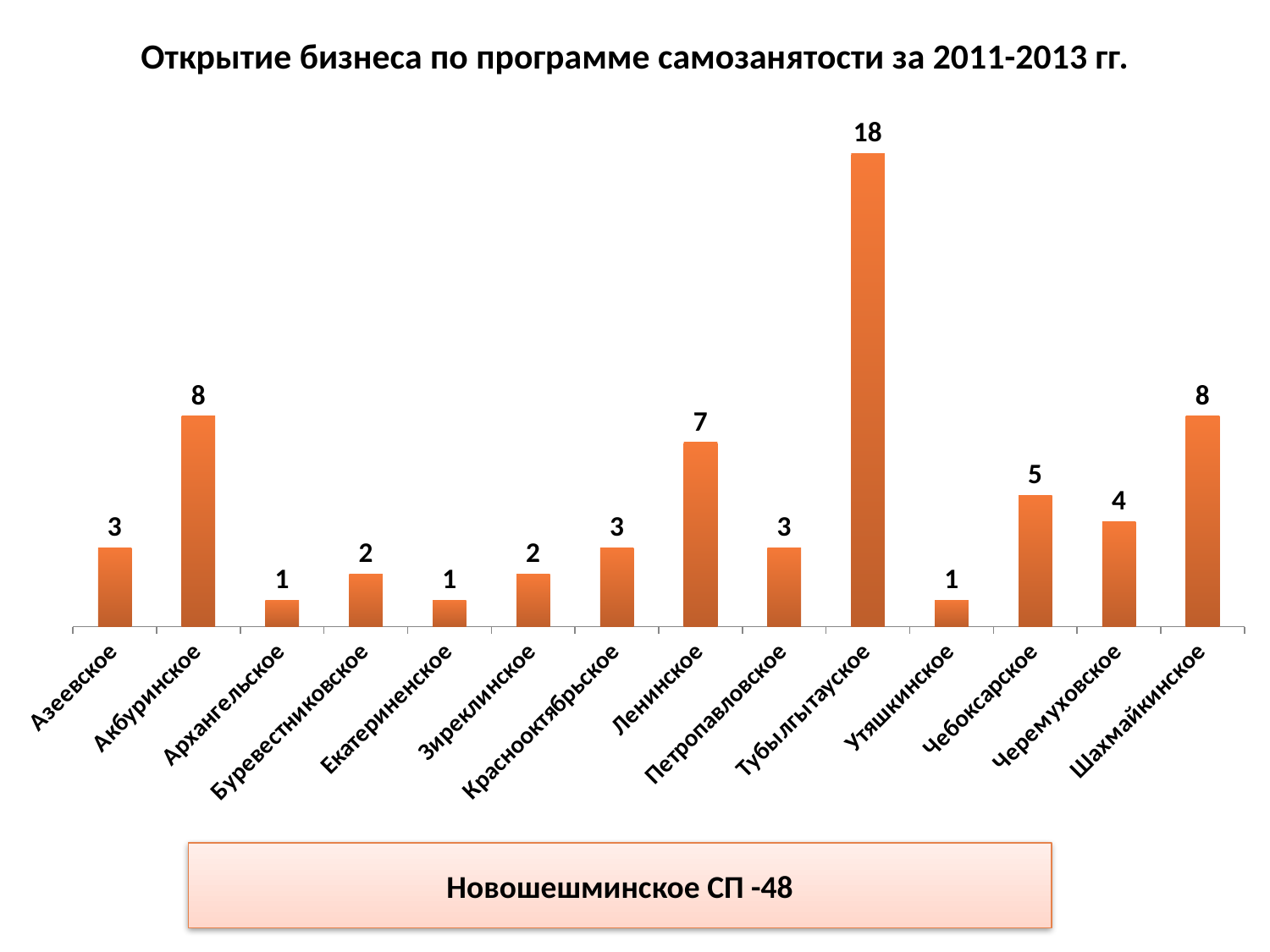
What is the title of the chart? Открытие бизнеса по программе самозанятости за 2011-2013 гг. How many categories have a value of 1? 3 What is the value for Тубылгытауское? 18 Which category has the highest value? Тубылгытауское What is the difference between the values for Тубылгытауское and Акбуринское? 10 What kind of chart is shown on the slide? bar chart What is the value for Чебоксарское? 5 What value is shown in the box below the chart for Новошешминское СП? 48 How many categories are shown on the x axis? 14 What is the value for Ленинское? 7 What is the difference between the values for Ленинское and Черемуховское? 3 Which is larger, the value for Чебоксарское or the value for Азеевское? Чебоксарское